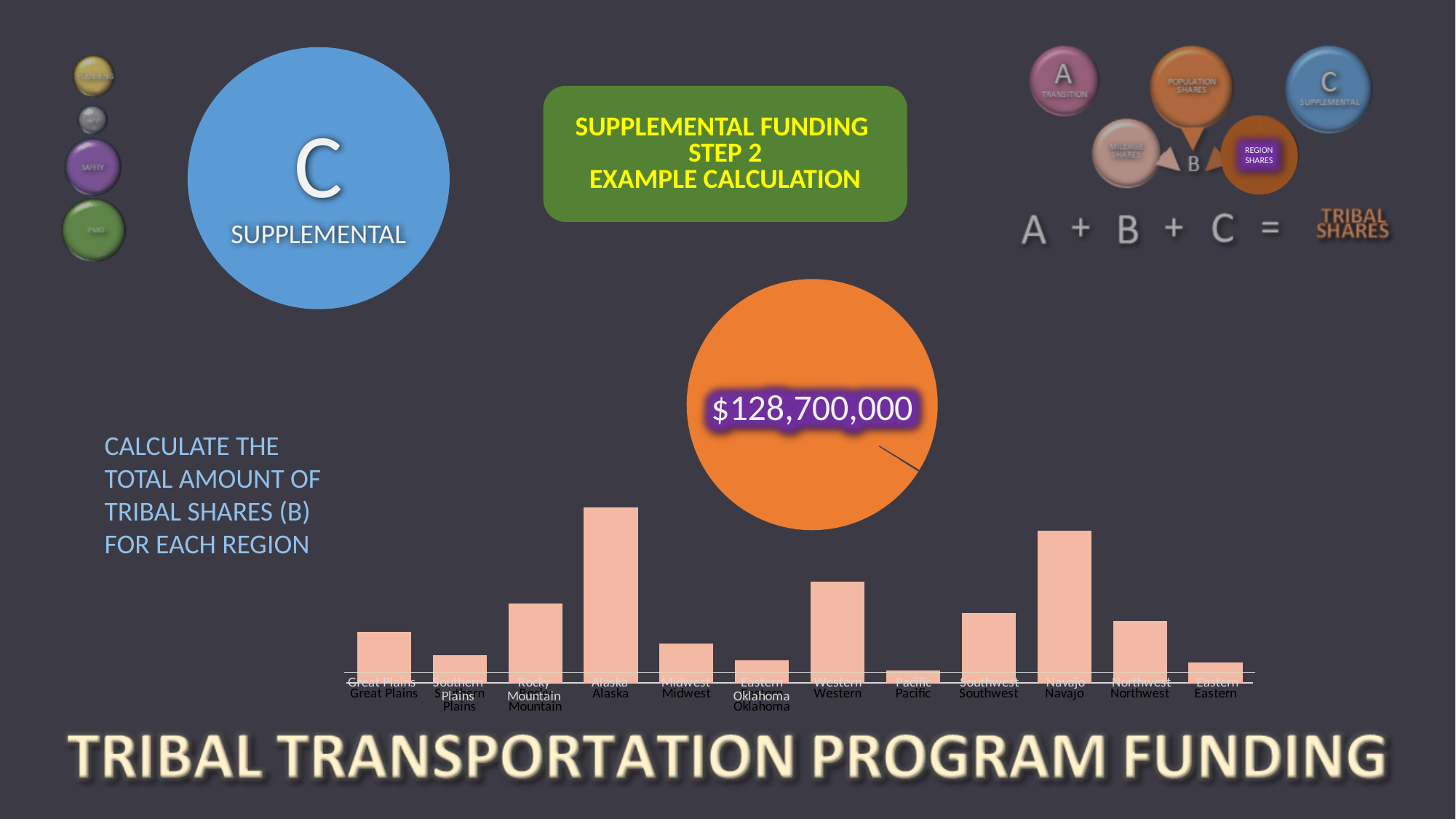
Which region has the tallest bar in the chart? Alaska Which bar is taller, Western or Eastern Oklahoma? Western Which region is the first category on the left of the bar chart? Great Plains What kind of chart is shown at the bottom of the slide? bar chart How many regions are shown as categories in the bar chart? 12 Which bar is taller, Navajo or Western? Navajo Which bar is taller, Southern Plains or Southwest? Southwest Which region has the shortest bar in the chart? Pacific Which region is the last category on the right of the bar chart? Eastern Which region has the second tallest bar in the chart? Navajo